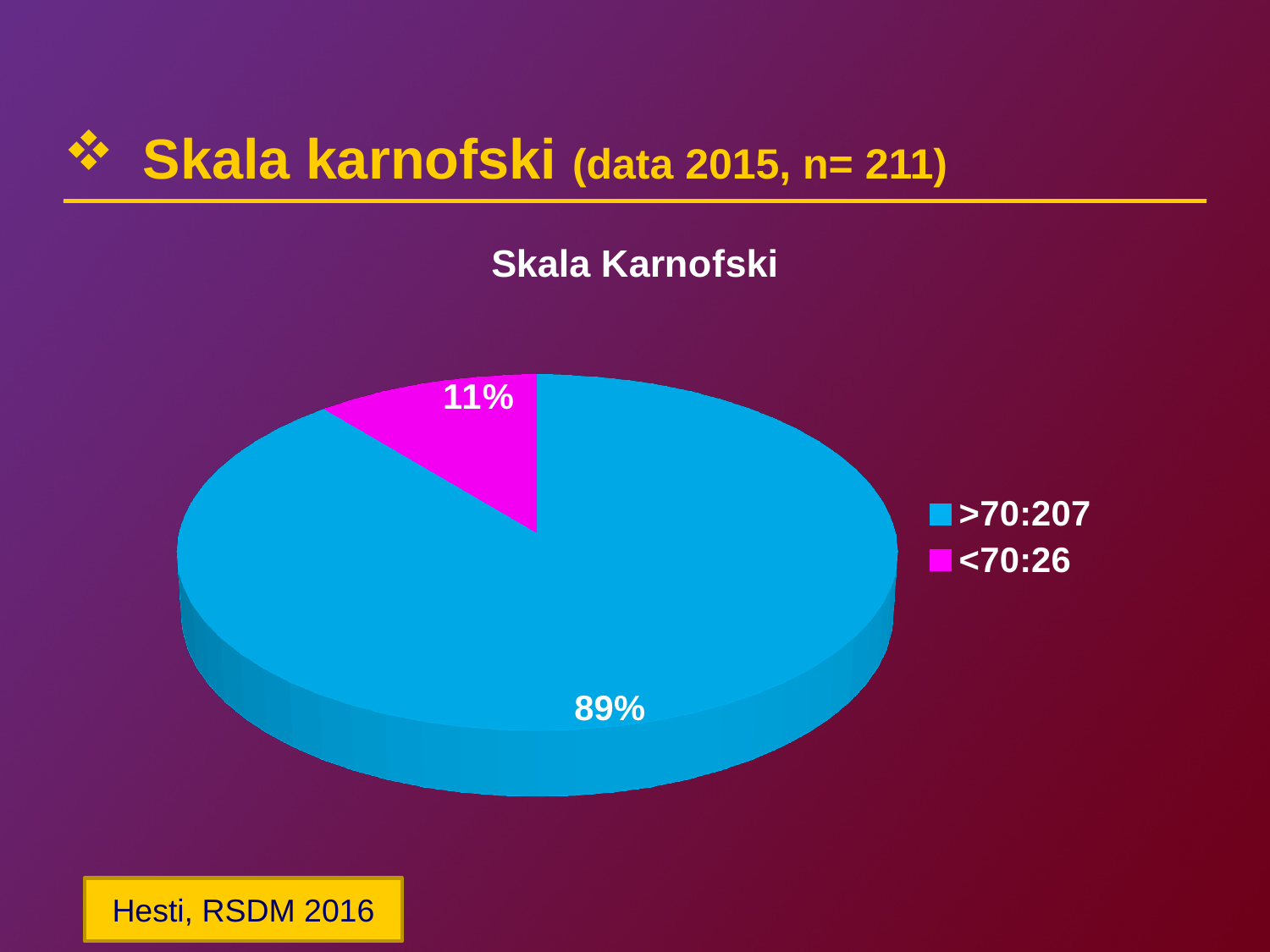
Which is larger, the >70:207 slice or the <70:26 slice? >70:207 What percentage share does the >70:207 slice have? 89% What kind of chart is shown on the slide? pie chart How many slices does the pie chart have? 2 What is the title of the chart? Skala Karnofski How many entries does the legend list? 2 Which slice is the smallest? <70:26 Which slice is the largest? >70:207 What colour is the <70:26 slice? magenta What percentage share does the <70:26 slice have? 11% What is the difference in percentage points between the 89% slice and the 11% slice? 78